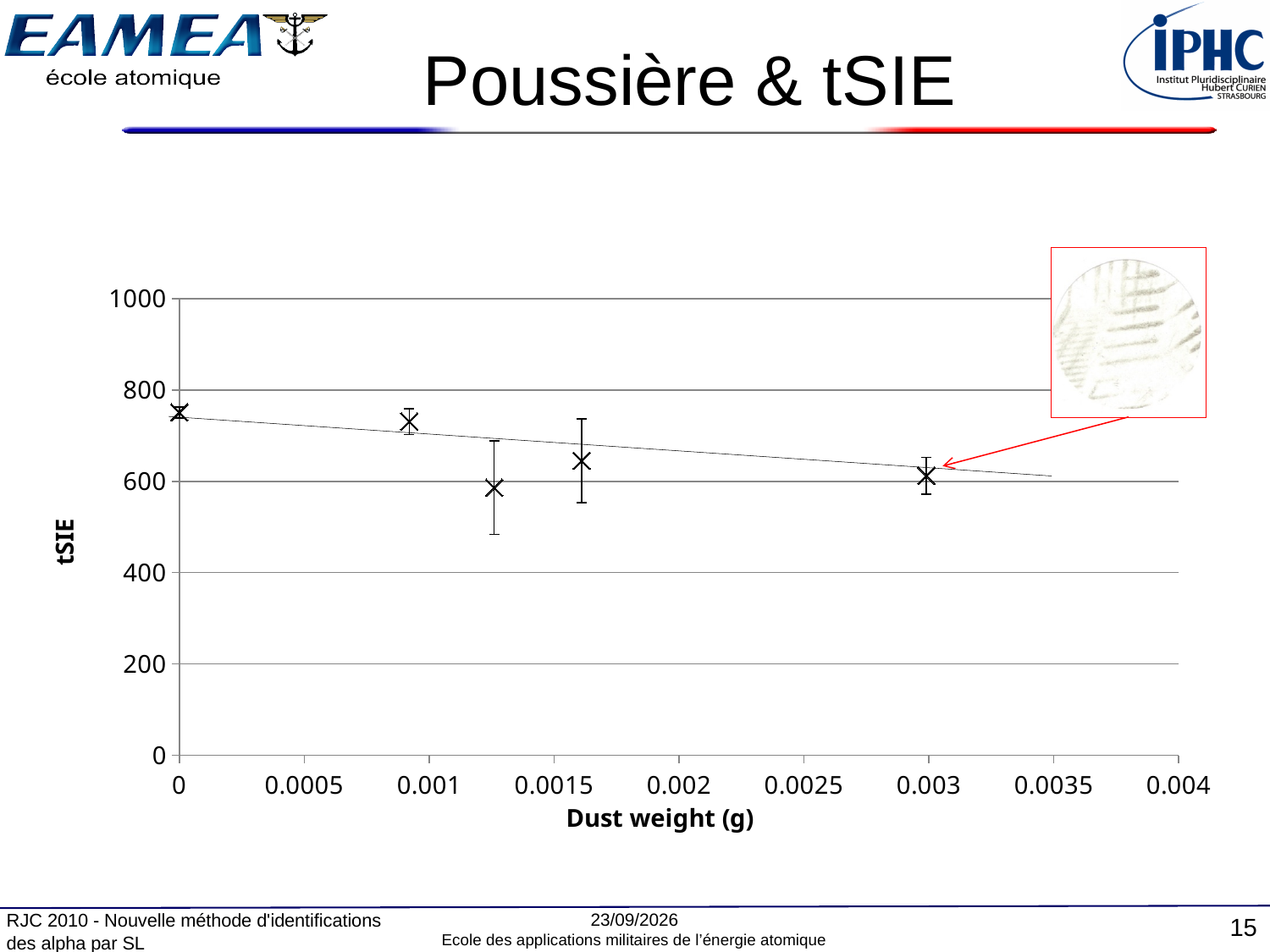
What kind of chart is shown on the slide? scatter chart Is the tSIE value at a dust weight of 0 g greater or less than 600? greater What is the title of the y axis? tSIE How many data points are plotted on the chart? 5 Is the tSIE value at a dust weight of about 0.0016 g greater or less than 400? greater What is the highest value shown on the y axis? 1000 Is the tSIE value at a dust weight of 0 g greater or less than 800? less Which has the larger tSIE value: the point at a dust weight of 0 g or the point at about 0.003 g? the point at 0 g Does tSIE generally rise or fall as dust weight increases along the x axis? fall What is the title of the x axis? Dust weight (g)